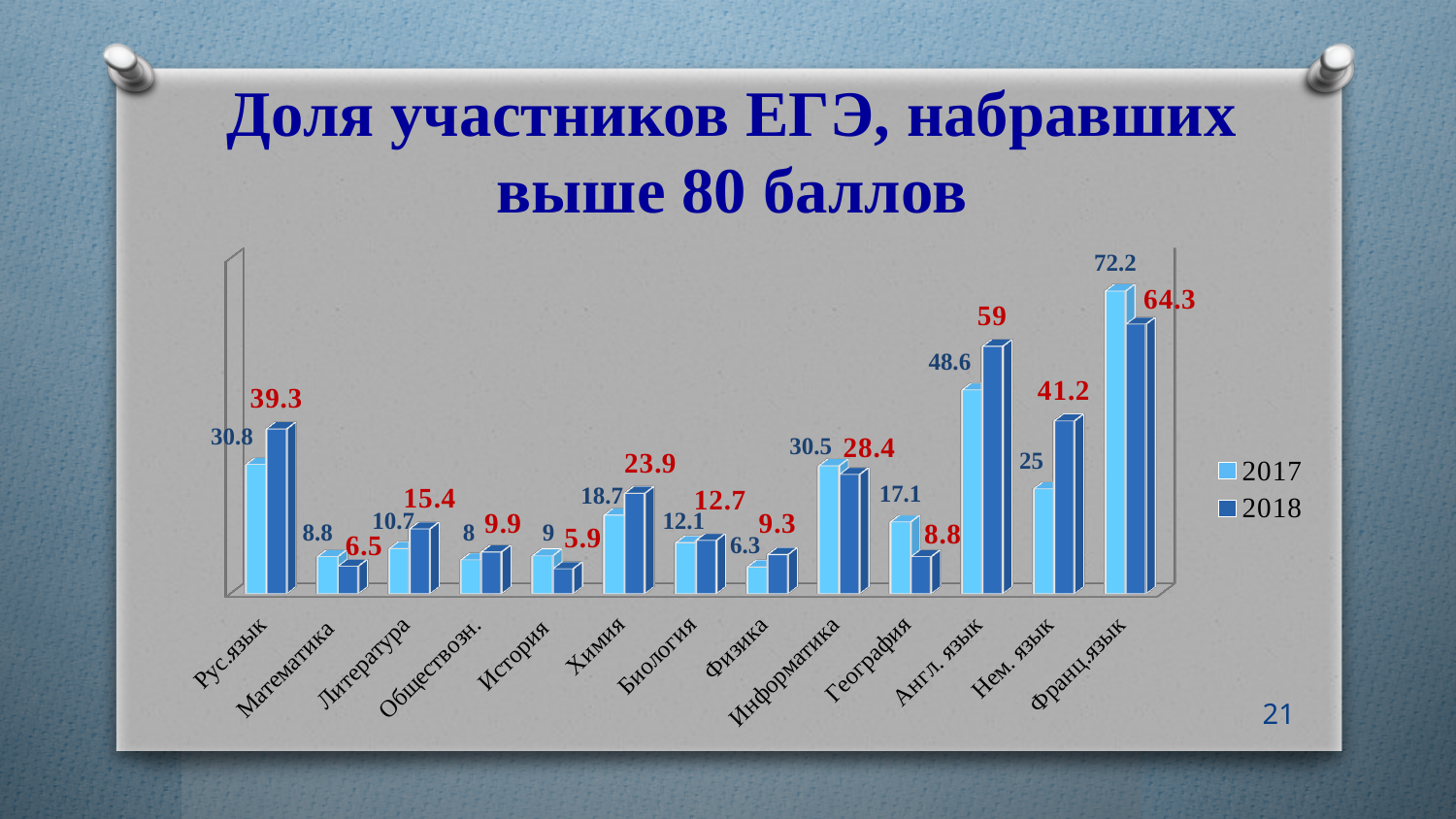
Which subject has the lowest 2018 value? История Which subject has the highest 2017 value? Франц.язык Which is larger for Математика, the 2017 value or the 2018 value? 2017 What is the difference between the 2017 and 2018 values for География? 8.3 What kind of chart is shown on the slide? Bar chart What is the 2017 value for Информатика? 30.5 How many series does the legend list? 2 What is the difference between the 2018 and 2017 values for Рус.язык? 8.5 What is the 2018 value for Нем. язык? 41.2 What is the 2018 value for Англ. язык? 59 Which is larger for Химия, the 2017 value or the 2018 value? 2018 How many subjects are shown on the x axis? 13